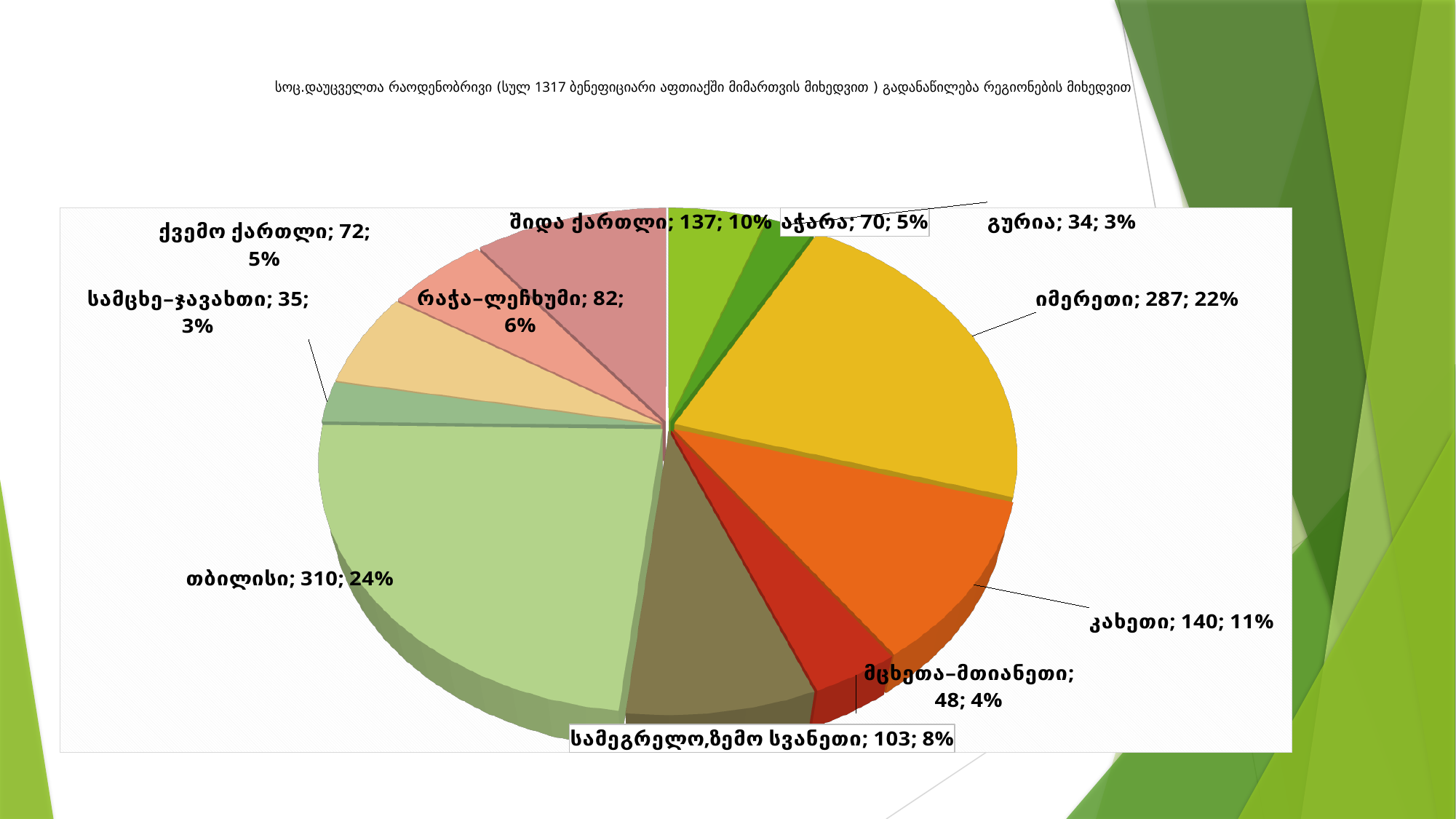
Which region has the largest slice? თბილისი Which region has the smallest slice? გურია What is the value for თბილისი? 310 What is the value for კახეთი? 140 What share of the pie does სამეგრელო,ზემო სვანეთი represent? 8% What is the difference between the values for თბილისი and იმერეთი? 23 What is the value for მცხეთა-მთიანეთი? 48 How many regions (slices) does the pie chart show? 11 Which is larger, the value for რაჭა-ლეჩხუმი or the value for ქვემო ქართლი? რაჭა-ლეჩხუმი What share of the pie does შიდა ქართლი represent? 10% What is the value for იმერეთი? 287 What kind of chart is shown on the slide? pie chart